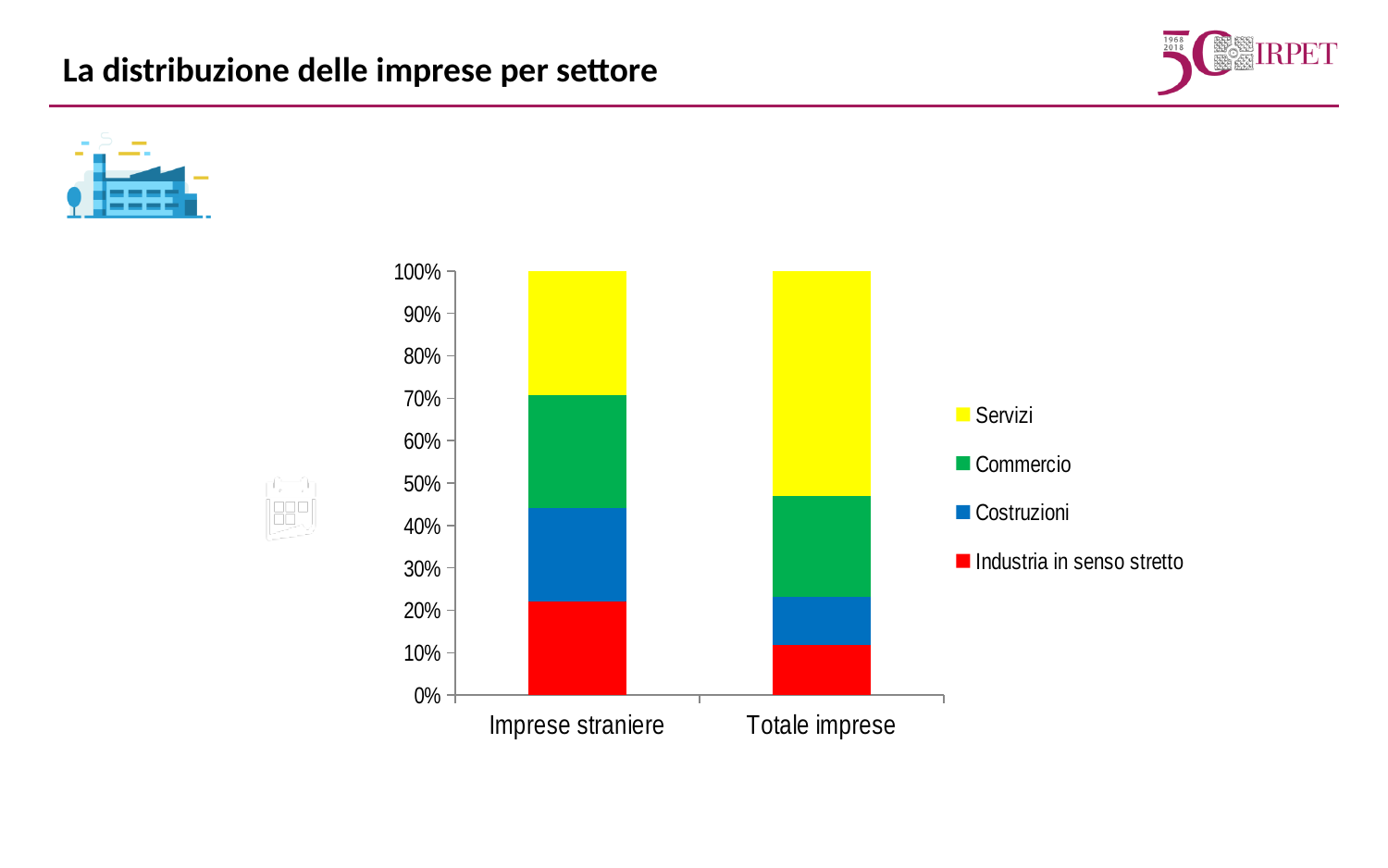
What is the title of the slide containing the chart? La distribuzione delle imprese per settore Which category has the larger Servizi share, Imprese straniere or Totale imprese? Totale imprese Is the Commercio share for Imprese straniere greater or less than 20%? greater What kind of chart is shown on the slide? Stacked bar chart How many categories are shown on the x axis of the chart? 2 How many series does the chart's legend list? 4 Is the Servizi share for Totale imprese greater or less than 40%? greater What is the total height of the stacked bar for Imprese straniere? 100% Is the Industria in senso stretto share for Totale imprese greater or less than 20%? less Which category has the larger Costruzioni share, Imprese straniere or Totale imprese? Imprese straniere Which series is shown in yellow in the chart? Servizi